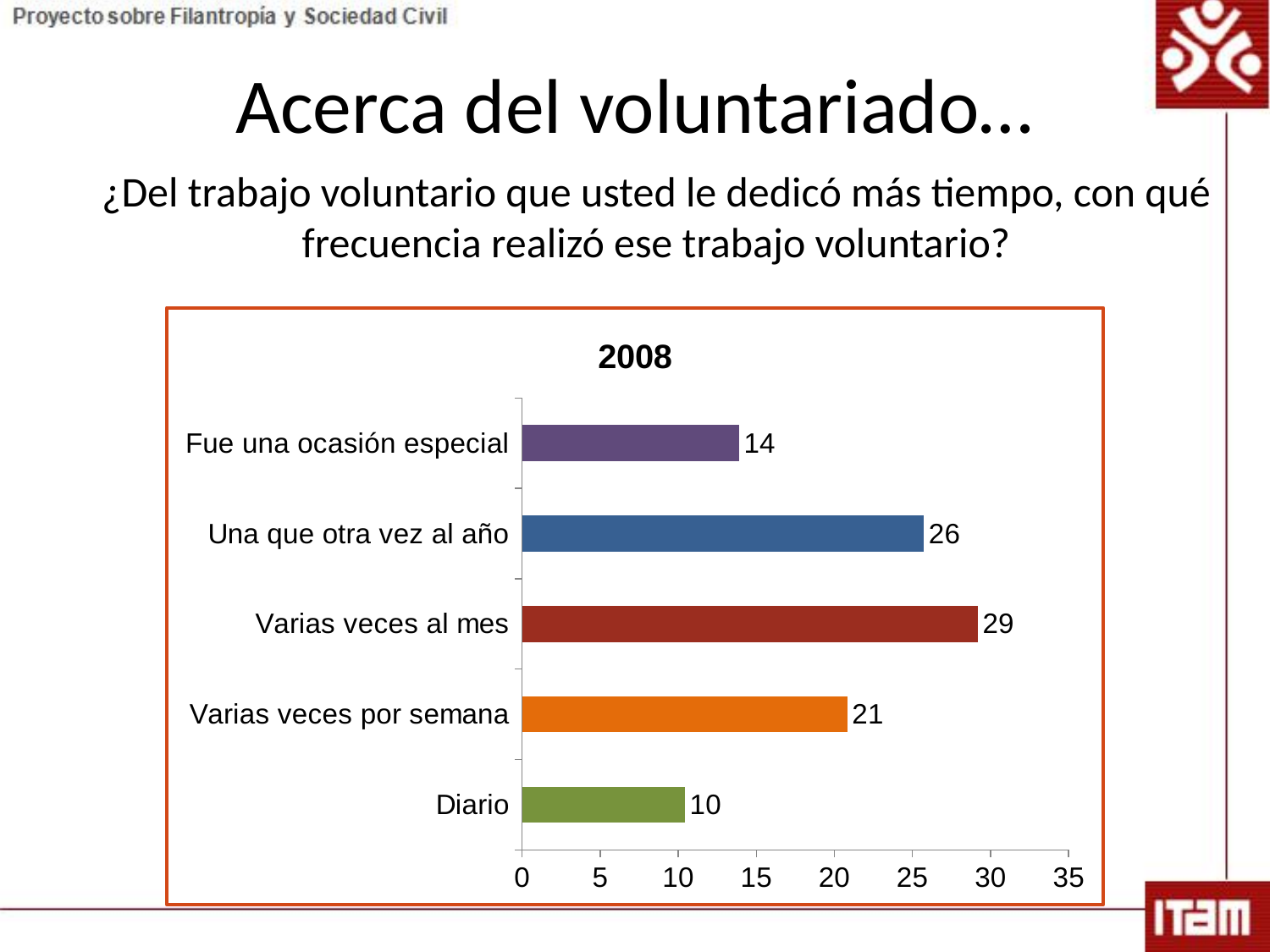
Is the value for "Varias veces por semana" greater or less than 25? less What is the title of the chart? 2008 What is the value for "Diario"? 10 Which is larger: "Varias veces por semana" or "Fue una ocasión especial"? Varias veces por semana How many categories are shown in the chart? 5 What kind of chart is shown? bar chart What is the value for "Varias veces al mes"? 29 Which category has the highest value? Varias veces al mes What is the value for "Una que otra vez al año"? 26 Which category has the lowest value? Diario What is the highest value shown on the x axis? 35 What is the difference between "Una que otra vez al año" and "Fue una ocasión especial"? 12